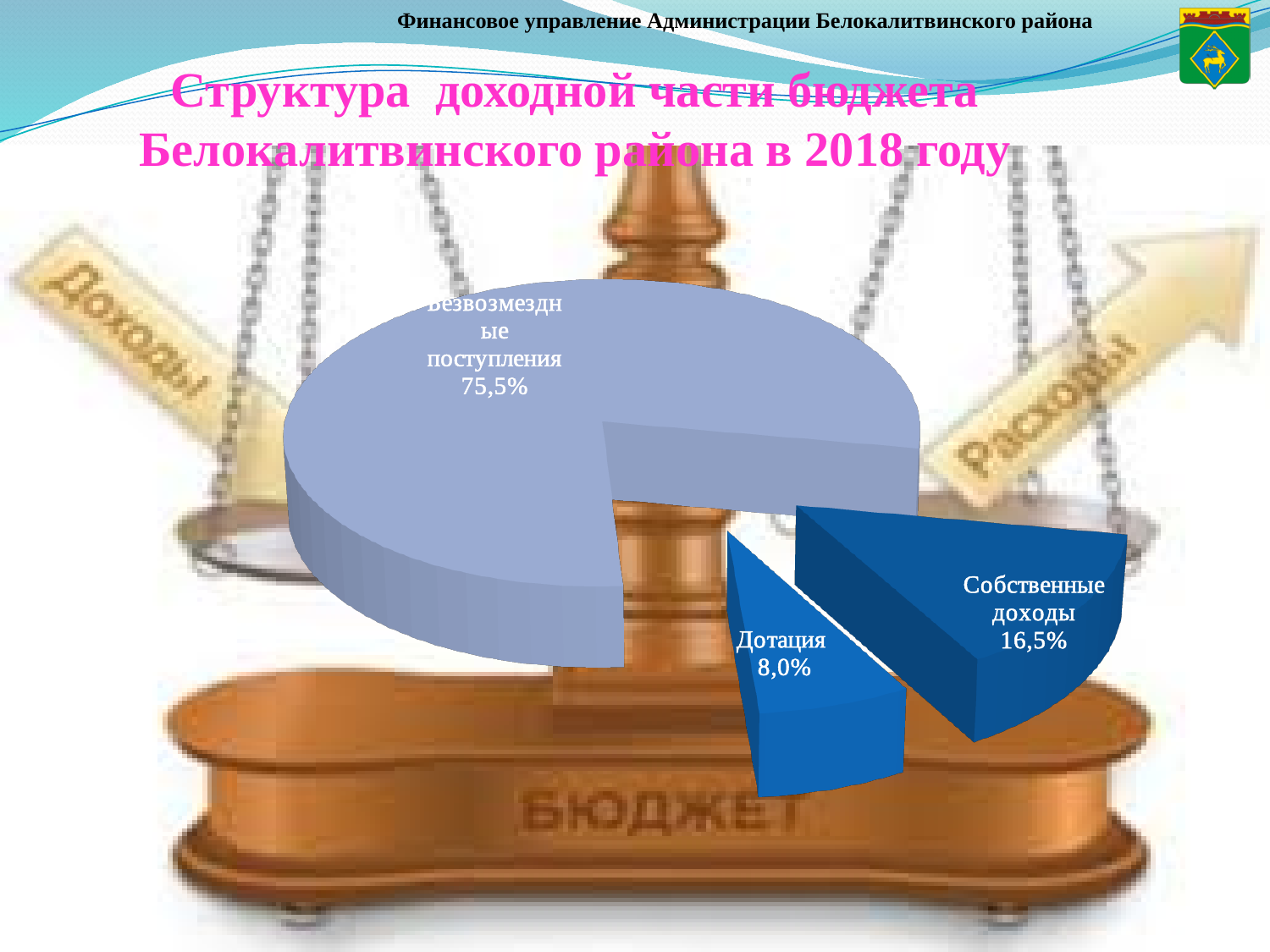
What is the difference between the shares of Собственные доходы and Дотация? 8,5% What is the value shown for Дотация? 8,0% How many slices does the pie chart have? 3 Which is larger, the share of Собственные доходы or the share of Дотация? Собственные доходы What share of the pie does Безвозмездные поступления account for? 75,5% What kind of chart is shown on the slide? Pie chart What is the difference between the shares of Безвозмездные поступления and Собственные доходы? 59,0% What year does the chart title refer to? 2018 What is the value shown for Собственные доходы? 16,5% What is the title of the chart on the slide? Структура доходной части бюджета Белокалитвинского района в 2018 году Which slice of the pie is the largest? Безвозмездные поступления Which slice of the pie is the smallest? Дотация